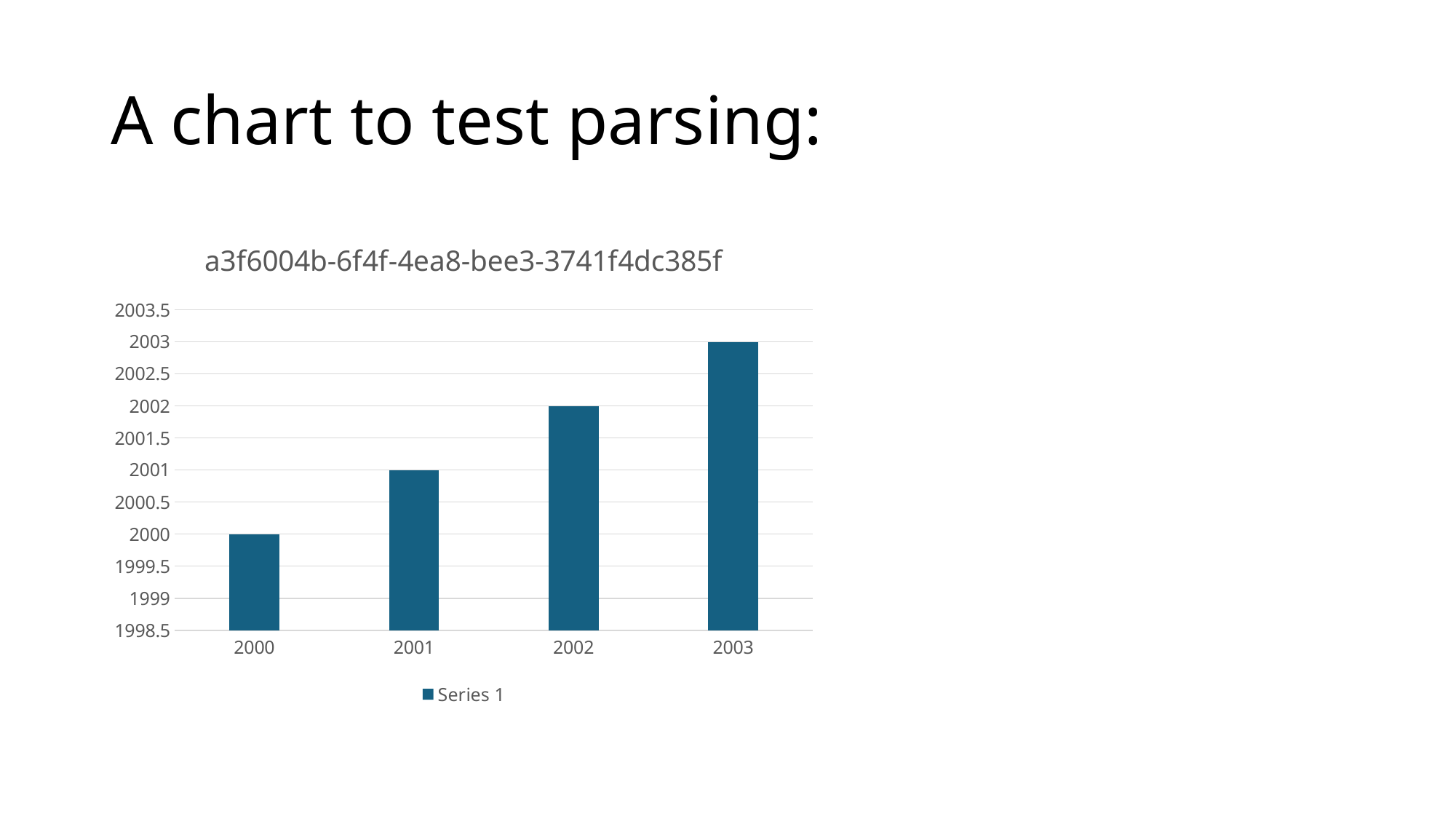
What is the difference between the values for 2003 and 2000? 3 What is the value for 2001? 2001 How many categories are shown on the x axis? 4 How many series does the legend list? 1 Which category has the highest value? 2003 What is the value for 2003? 2003 Is the value for 2002 greater or less than 2001? greater Do the values rise or fall from 2000 to 2003? rise Which category has the lowest value? 2000 What kind of chart is shown on the slide? bar chart Which is larger, the value for 2002 or the value for 2001? 2002 What is the value for 2000? 2000